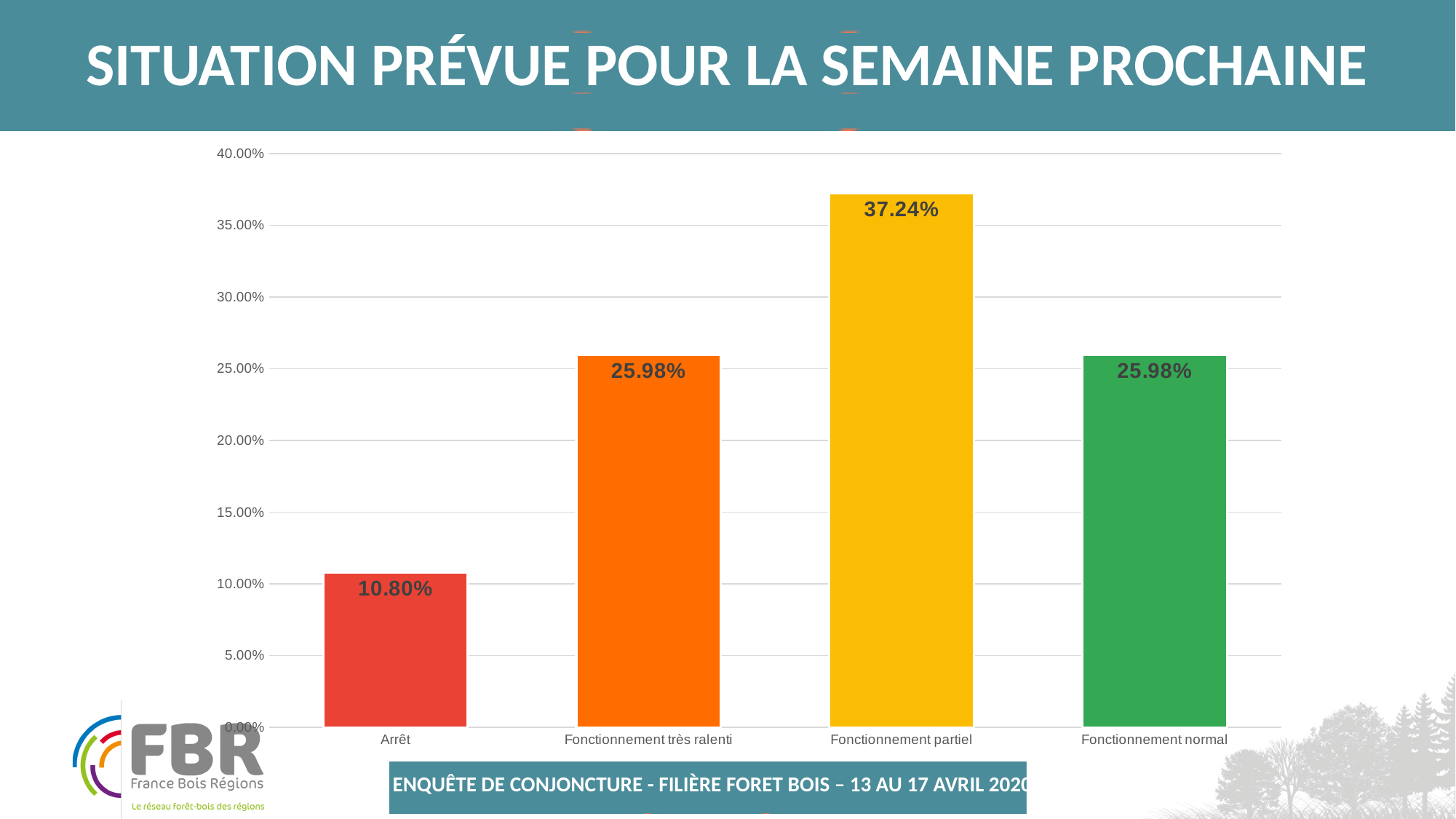
What is the value for Fonctionnement partiel? 37.24% What kind of chart is shown on the slide? Bar chart Which category has the highest value? Fonctionnement partiel How many categories are shown on the chart? 4 Which category has the lowest value? Arrêt What is the value for Fonctionnement très ralenti? 25.98% What is the value for Arrêt? 10.80% What is the value for Fonctionnement normal? 25.98% What is the difference between the values for Fonctionnement partiel and Fonctionnement normal? 11.26% What is the difference between the values for Fonctionnement partiel and Arrêt? 26.44% Which is larger, the value for Fonctionnement très ralenti or the value for Arrêt? Fonctionnement très ralenti What colour is the bar for Fonctionnement partiel? Yellow